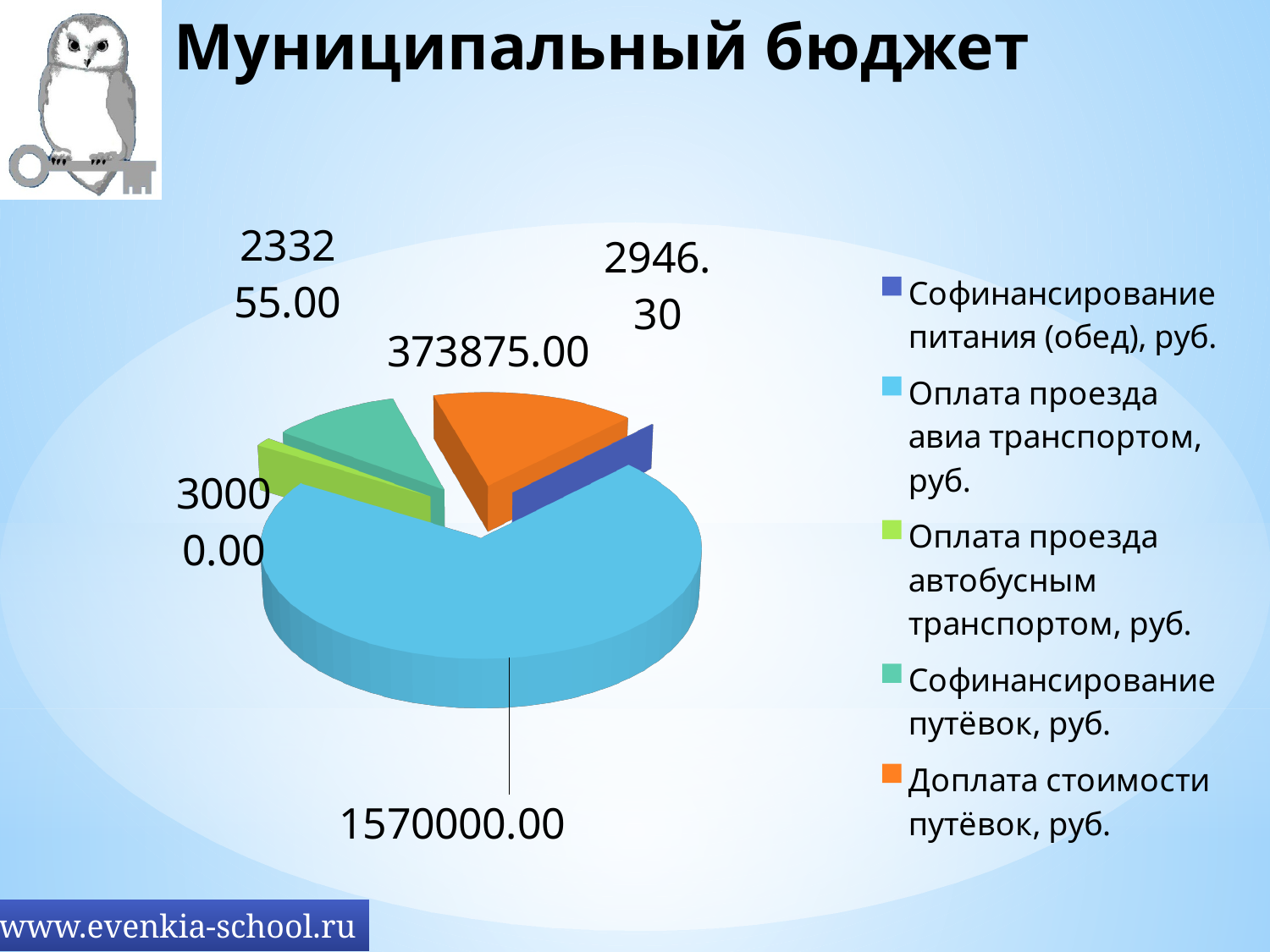
Which category has the largest slice of the pie? Оплата проезда авиа транспортом, руб. What is the value for Оплата проезда авиа транспортом, руб.? 1570000.00 How many entries does the legend of the pie chart list? 5 What is the value for Софинансирование путёвок, руб.? 233255.00 Which category has the smallest slice of the pie? Софинансирование питания (обед), руб. What is the title of the slide containing the pie chart? Муниципальный бюджет What is the value for Софинансирование питания (обед), руб.? 2946.30 How many slices does the pie chart have? 5 What is the difference between Доплата стоимости путёвок (373875.00) and Софинансирование путёвок (233255.00)? 140620.00 What is the value for Доплата стоимости путёвок, руб.? 373875.00 What kind of chart is shown on the slide? pie chart Which is larger: Доплата стоимости путёвок or Софинансирование путёвок? Доплата стоимости путёвок